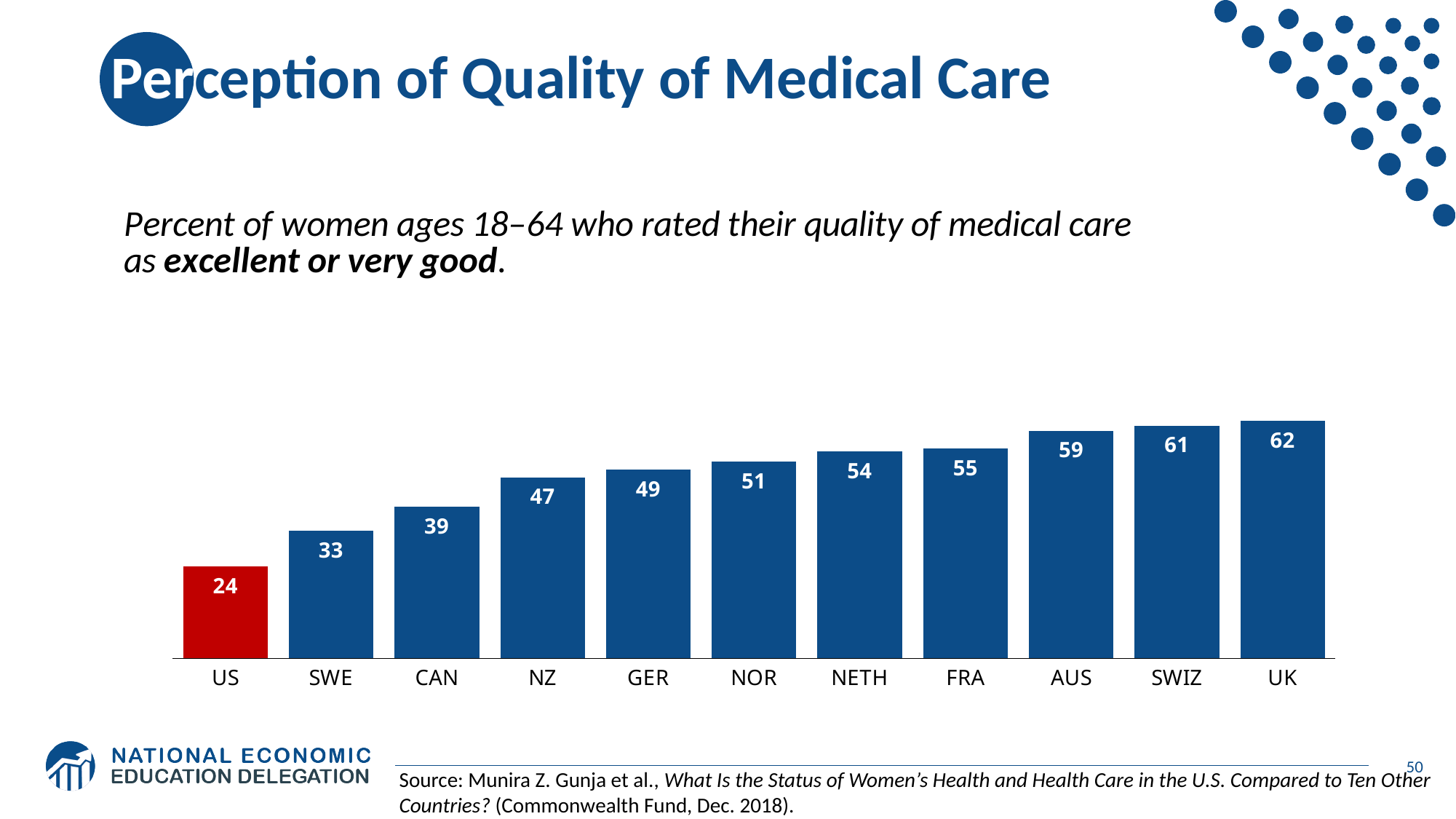
How many countries are shown in the chart? 11 Which is larger, the value for SWE or the value for NZ? NZ What kind of chart is shown on the slide? bar chart Which bar is coloured red rather than blue? US What is the value for GER? 49 What is the difference between the values for NETH and CAN? 15 What is the value for AUS? 59 Do the values rise or fall from left to right along the x axis? rise Which country has the highest value? UK Which country has the lowest value? US What is the difference between the values for UK and US? 38 What is the value for the US? 24